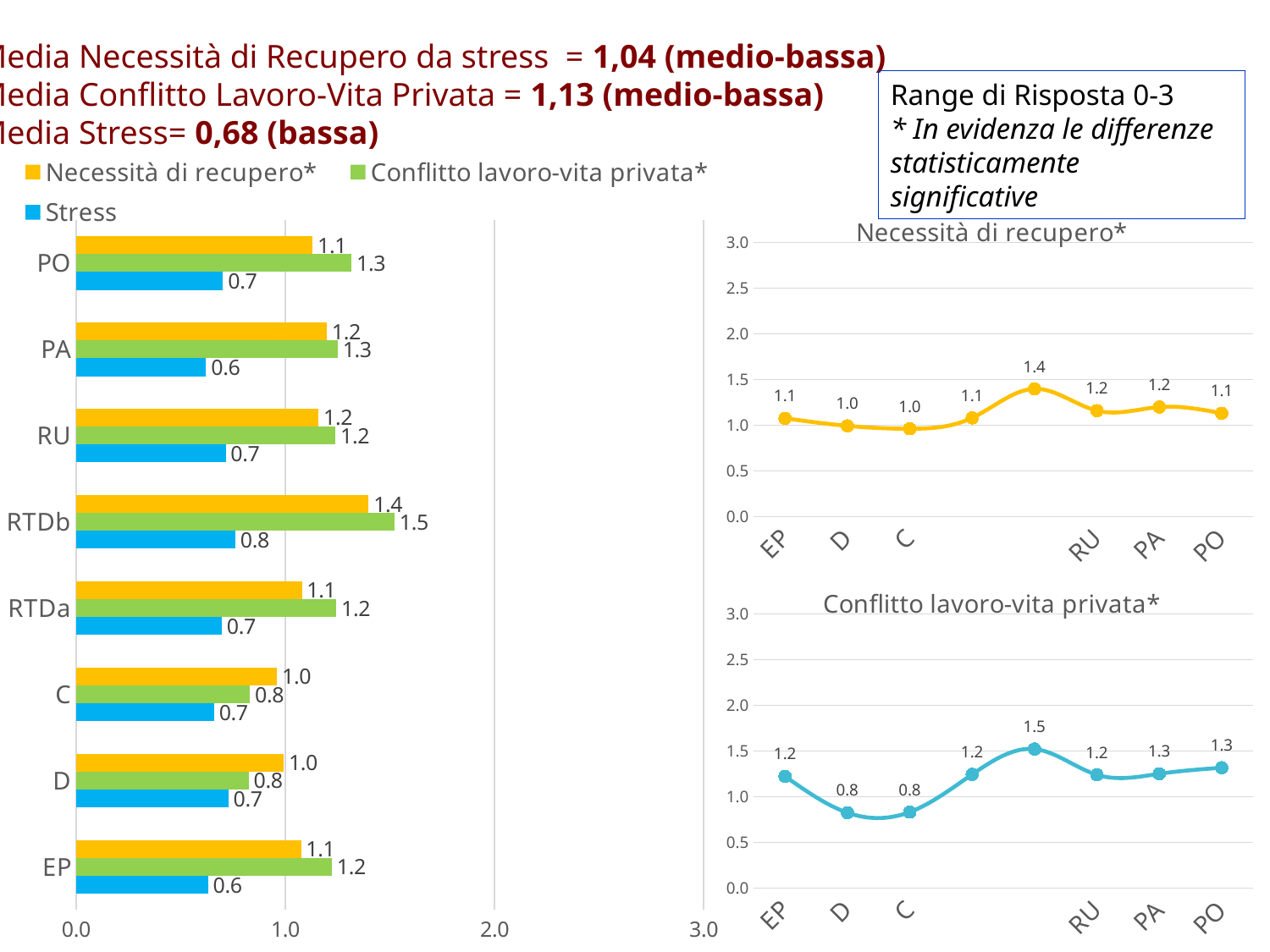
In the bar chart on the left, which category has the highest Conflitto lavoro-vita privata value? RTDb In the chart titled 'Necessità di recupero*', what is the value for D? 1.0 In the bar chart on the left, what is the Conflitto lavoro-vita privata value for PA? 1.3 What kind of chart is the chart on the left of the slide? bar chart What kind of chart is the chart titled 'Conflitto lavoro-vita privata*'? line chart In the bar chart on the left, is the Necessità di recupero value for PA larger or the Stress value for PA? Necessità di recupero In the chart titled 'Conflitto lavoro-vita privata*', what is the difference between the values for EP and D? 0.4 In the chart titled 'Conflitto lavoro-vita privata*', what is the value for PA? 1.3 In the bar chart on the left, what is the Stress value for RTDb? 0.8 How many series does the legend of the bar chart on the left list? 3 How many categories are shown in the bar chart on the left? 8 In the bar chart on the left, what is the difference between the Necessità di recupero value and the Stress value for RTDb? 0.6